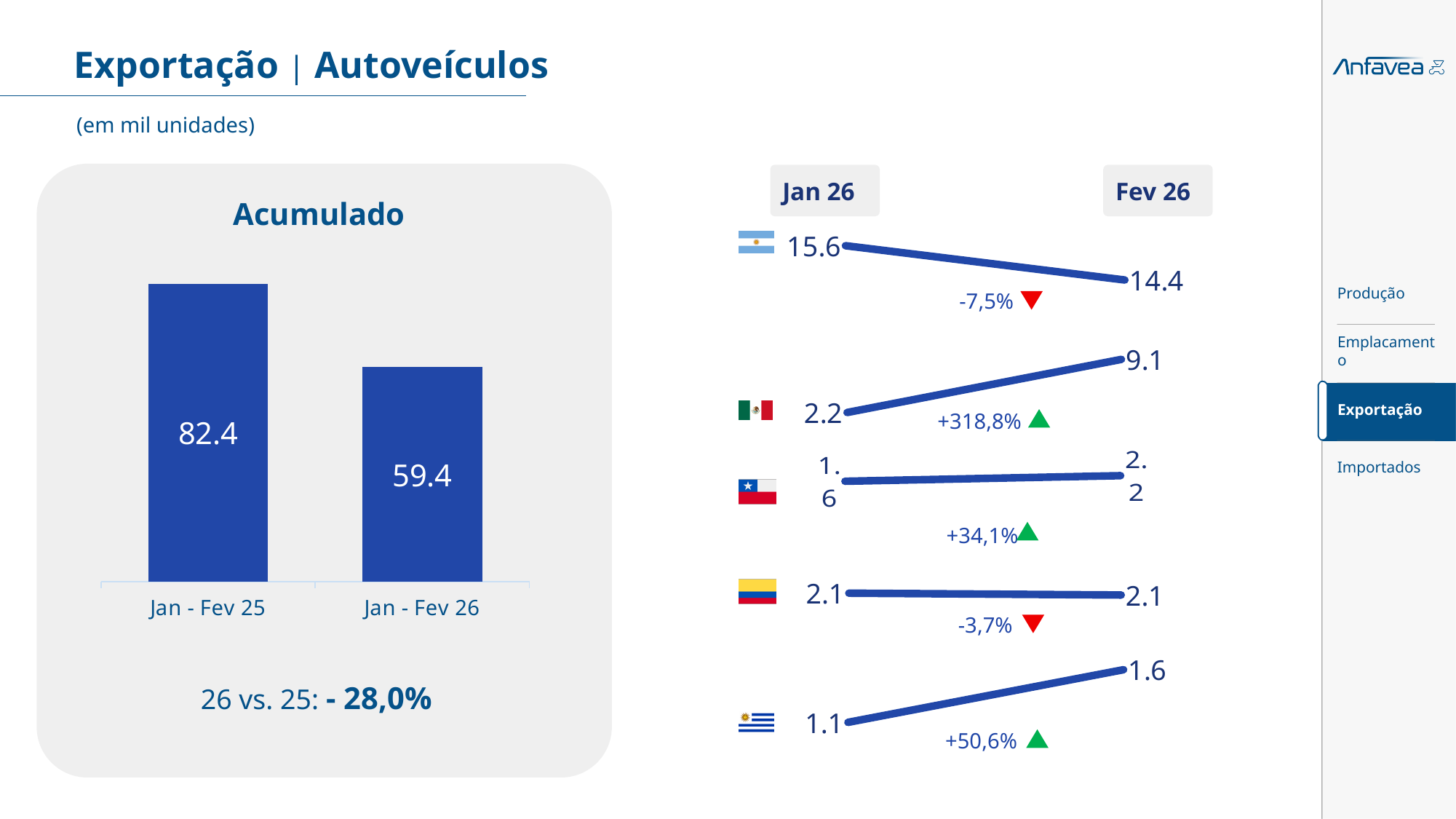
How many bars does the Acumulado bar chart show? 2 In the bottom line chart on the right (Uruguay flag), what is the value for Fev 26? 1.6 What kind of chart is the Acumulado chart on the left? Bar chart In the Acumulado bar chart, which period has the higher value? Jan - Fev 25 In the topmost line chart on the right (Argentina flag), what is the value for Jan 26? 15.6 What percentage change is shown below the Acumulado bar chart for 26 vs. 25? - 28,0% How many line charts are shown on the right side of the slide? 5 In the Acumulado bar chart, what is the value for Jan - Fev 26? 59.4 In the Acumulado bar chart, what is the difference between the Jan - Fev 25 and Jan - Fev 26 values? 23.0 In the Acumulado bar chart, what is the value for Jan - Fev 25? 82.4 In the second line chart from the top on the right (Mexico flag), does the value rise or fall from Jan 26 to Fev 26? Rise In the topmost line chart on the right (Argentina flag), what is the value for Fev 26? 14.4